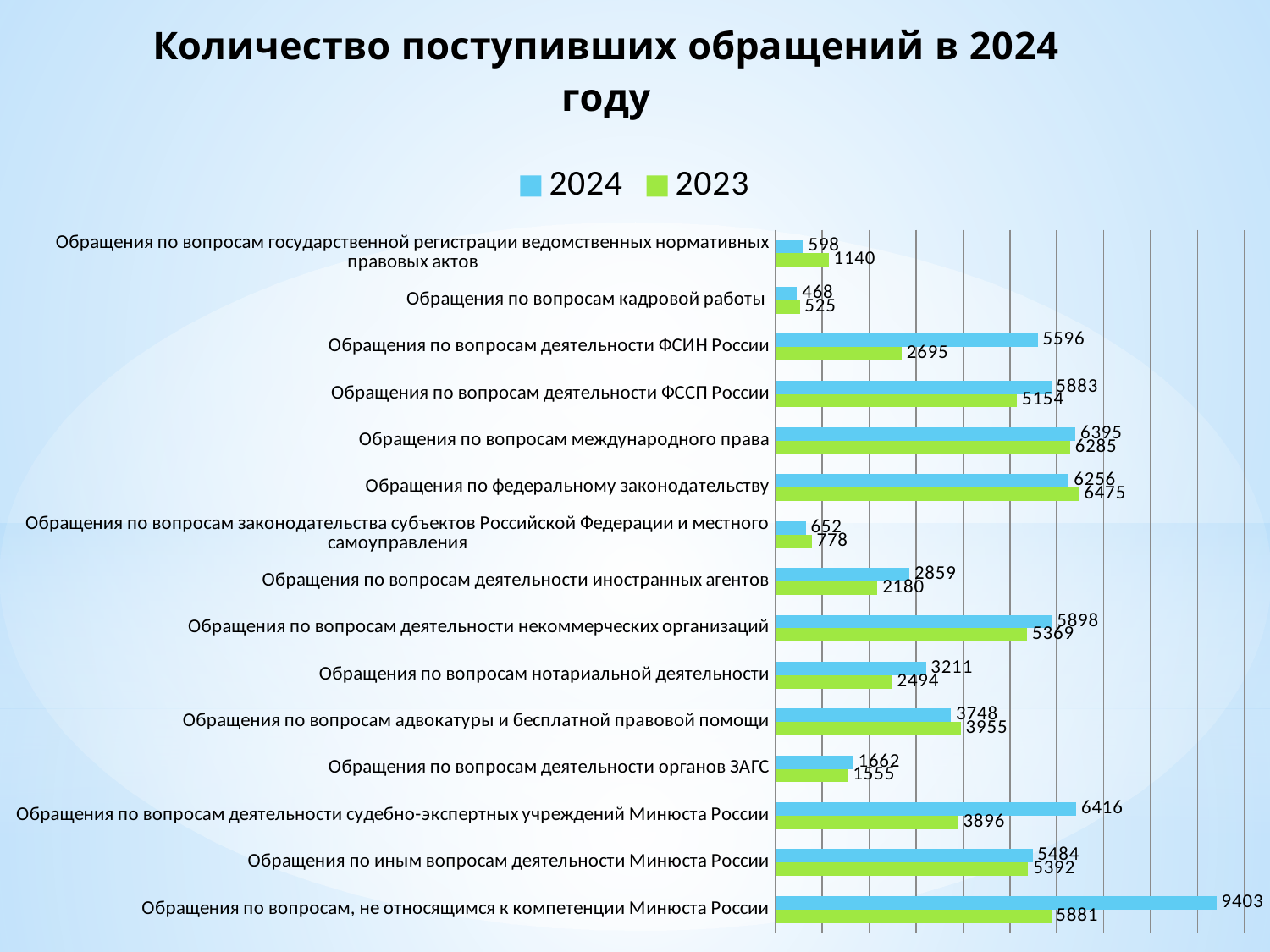
How many categories are shown in the chart? 15 What type of chart is shown on the slide? Bar chart Which category has the lowest 2024 value? Обращения по вопросам кадровой работы What is the 2023 value for "Обращения по вопросам нотариальной деятельности"? 2494 What is the title of the chart? Количество поступивших обращений в 2024 году How many series does the legend list? 2 What is the difference between the 2024 and 2023 values for "Обращения по вопросам государственной регистрации ведомственных нормативных правовых актов"? 542 What is the difference between the 2024 and 2023 values for "Обращения по вопросам деятельности судебно-экспертных учреждений Минюста России"? 2520 For "Обращения по вопросам адвокатуры и бесплатной правовой помощи", which year has the larger value, 2024 or 2023? 2023 Which category has the highest 2024 value? Обращения по вопросам, не относящимся к компетенции Минюста России What is the 2024 value for "Обращения по вопросам деятельности ФСИН России"? 5596 Which category has the highest 2023 value? Обращения по федеральному законодательству